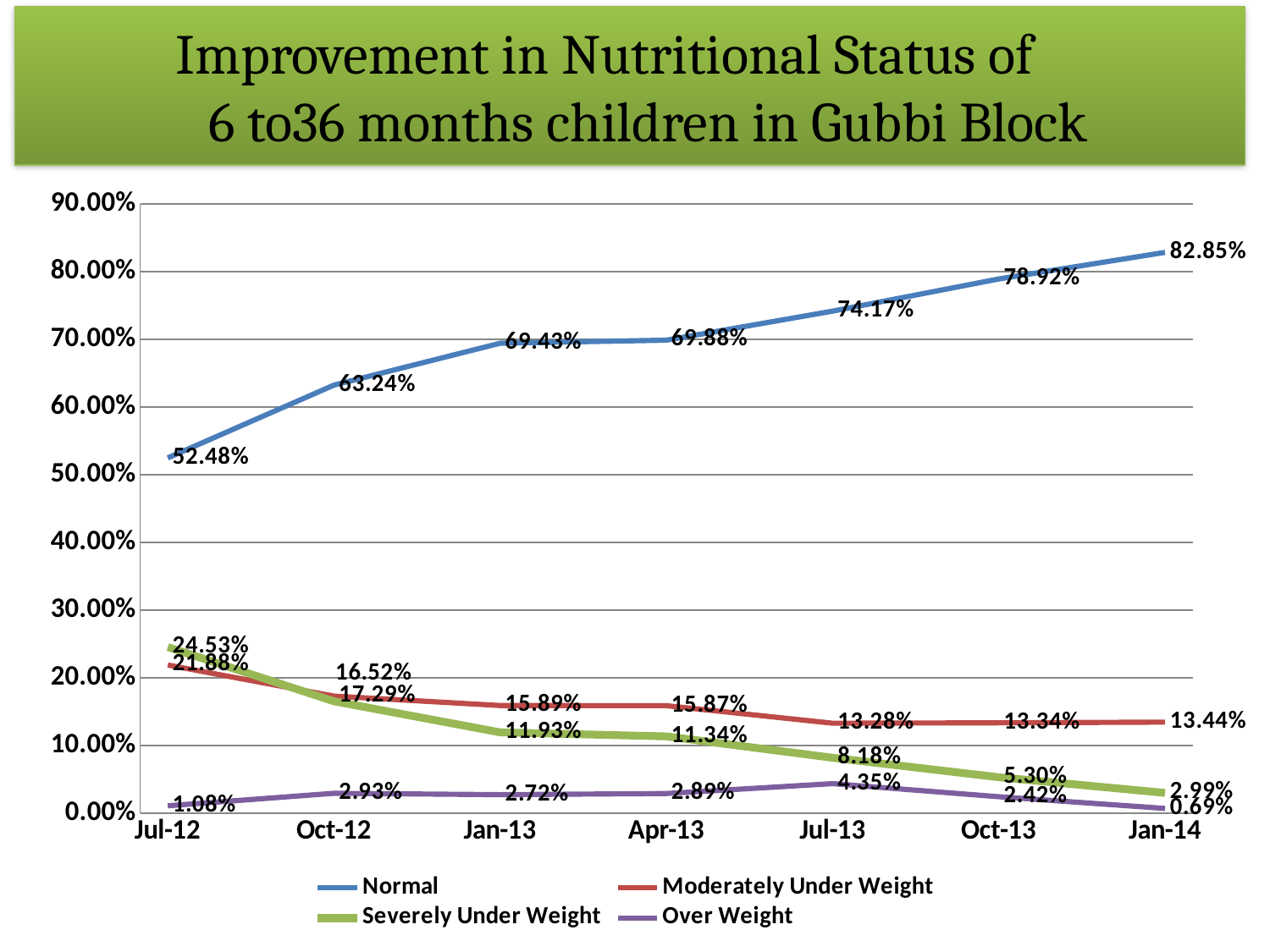
Does the Severely Under Weight series rise or fall from Jul-12 to Jan-14? Falls How many series does the legend list? 4 By how many percentage points did the Normal value increase from Jul-12 to Jan-14? 30.37 percentage points What is the value for Over Weight in Jul-13? 4.35% Does the Normal series rise or fall from Jul-12 to Jan-14? Rises In Jul-13, which is larger: Moderately Under Weight or Severely Under Weight? Moderately Under Weight How many time points are plotted along the x axis? 7 What is the value for Normal in Jan-14? 82.85% At which time point is the Over Weight value lowest? Jan-14 What is the value for Normal in Jul-12? 52.48% What kind of chart is shown on the slide? Line chart What is the value for Severely Under Weight in Jan-14? 2.99%